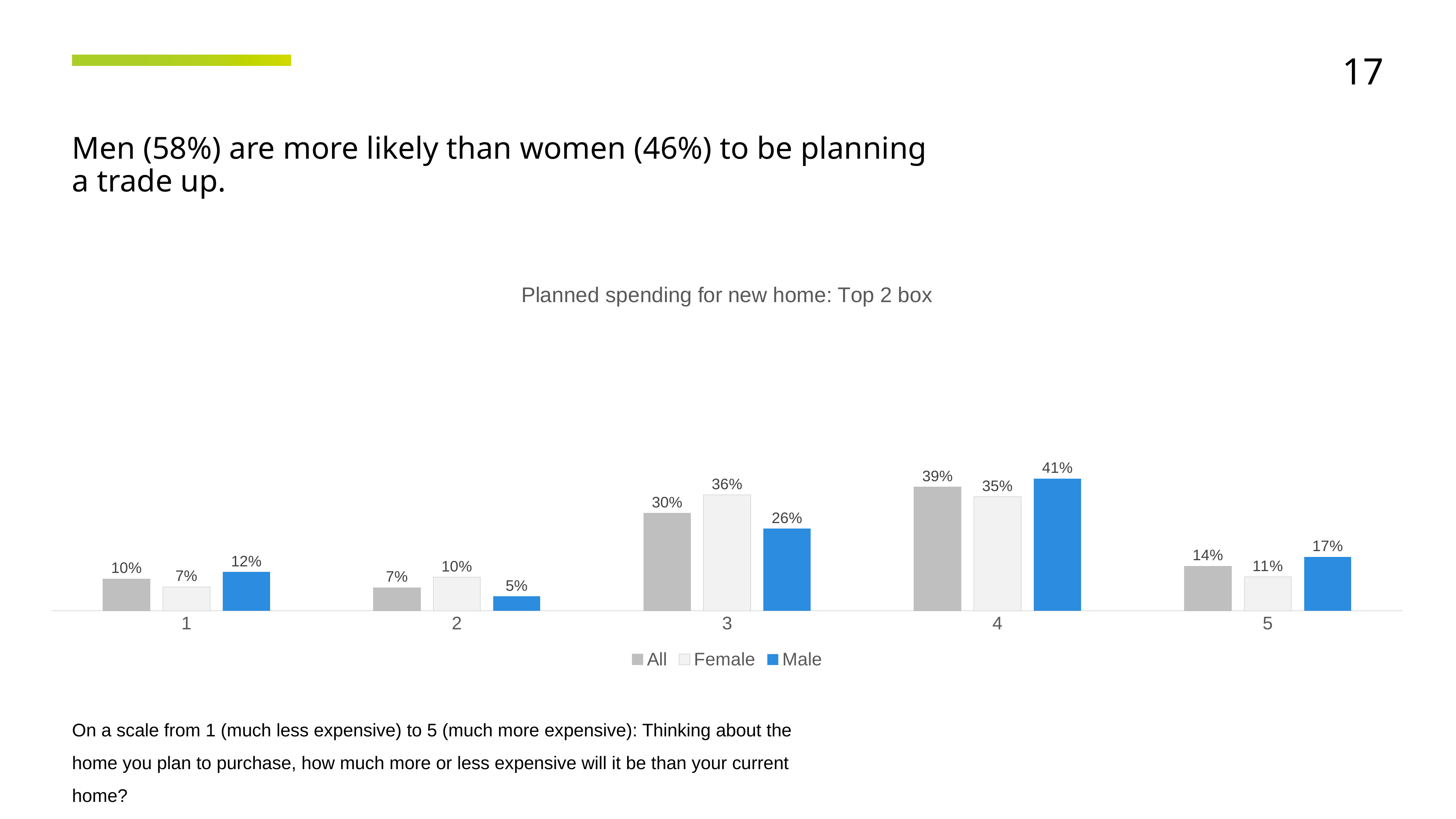
What is the title of the chart? Planned spending for new home: Top 2 box What kind of chart is shown on the slide? Bar chart What is the difference between the Male and Female values at category 4? 6% Which category has the lowest value for the Male series? 2 What is the value for Male at category 2? 5% What is the value for Female at category 3? 36% Which is larger at category 3: the Female value or the Male value? Female How many series does the legend list? 3 How many categories are shown on the x axis? 5 What is the value for All at category 5? 14% What is the value for Male at category 4? 41% Which category has the highest value for the All series? 4